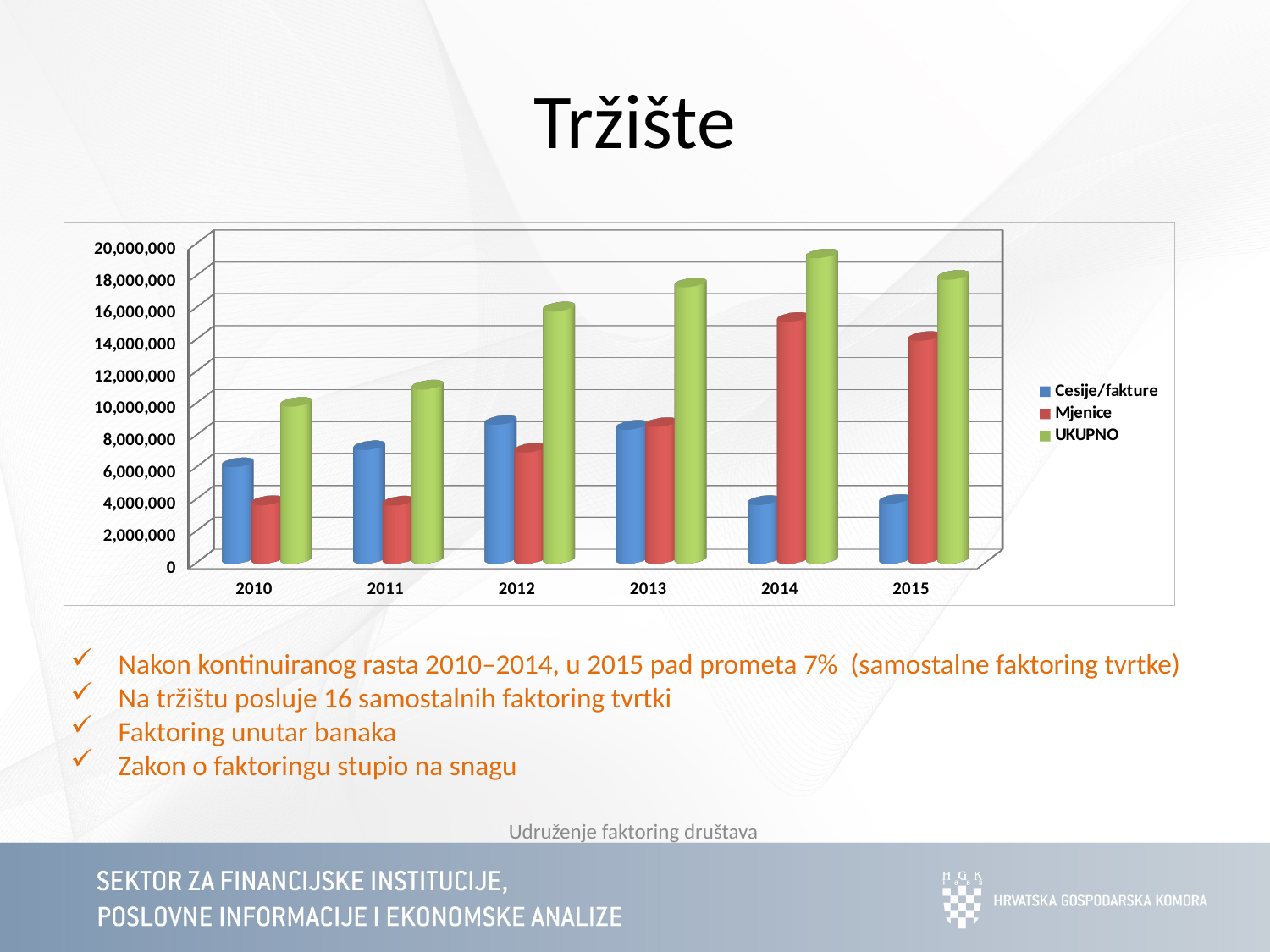
How many series does the chart legend list? 3 How many years are shown on the x axis of the chart? 6 In 2014, which is larger: Cesije/fakture or Mjenice? Mjenice In 2010, which is larger: Cesije/fakture or Mjenice? Cesije/fakture Which colour represents the UKUPNO series in the chart? Green Is the Cesije/fakture value for 2012 greater or less than 8,000,000? greater Is the Mjenice value for 2010 greater or less than 6,000,000? less In which year is the UKUPNO value highest? 2014 In which year is the UKUPNO value lowest? 2010 Is the UKUPNO value for 2014 greater or less than 18,000,000? greater What kind of chart is shown on the slide? Bar chart Does the UKUPNO value rise or fall from 2010 to 2014? Rise